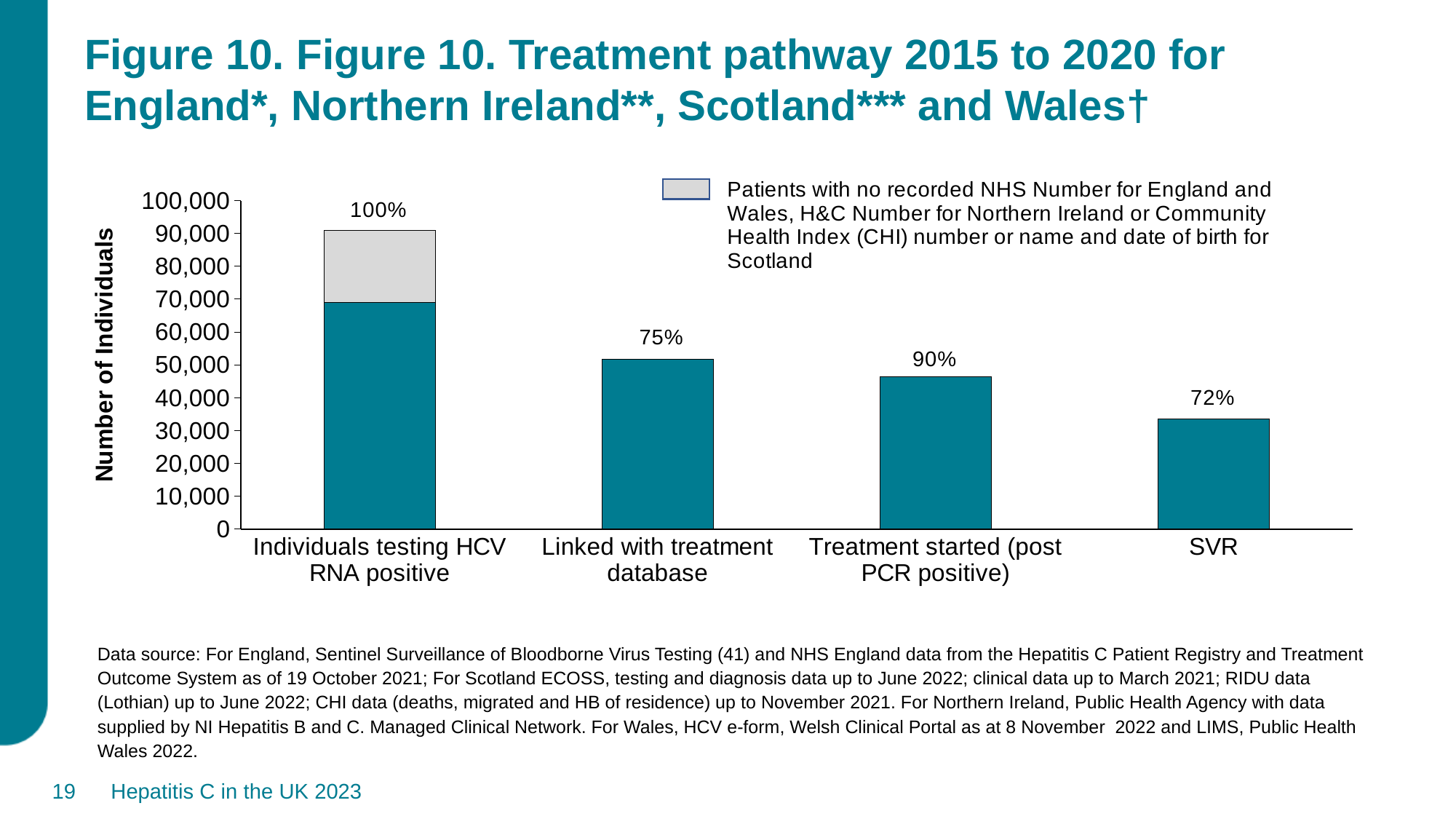
What percentage label is shown above the 'Treatment started (post PCR positive)' bar? 90% Which category has the shortest bar? SVR What percentage label is shown above the 'Linked with treatment database' bar? 75% Is the value for 'SVR' greater or less than 40,000? less What percentage label is shown above the 'SVR' bar? 72% What kind of chart is shown on the slide? Bar chart Which category has the tallest bar? Individuals testing HCV RNA positive How many categories are shown on the x axis? 4 Is the value for 'Treatment started (post PCR positive)' greater or less than 50,000? less Is the total height of the 'Individuals testing HCV RNA positive' bar greater or less than 80,000? greater What percentage label is shown above the 'Individuals testing HCV RNA positive' bar? 100% What is the title of the y axis? Number of Individuals